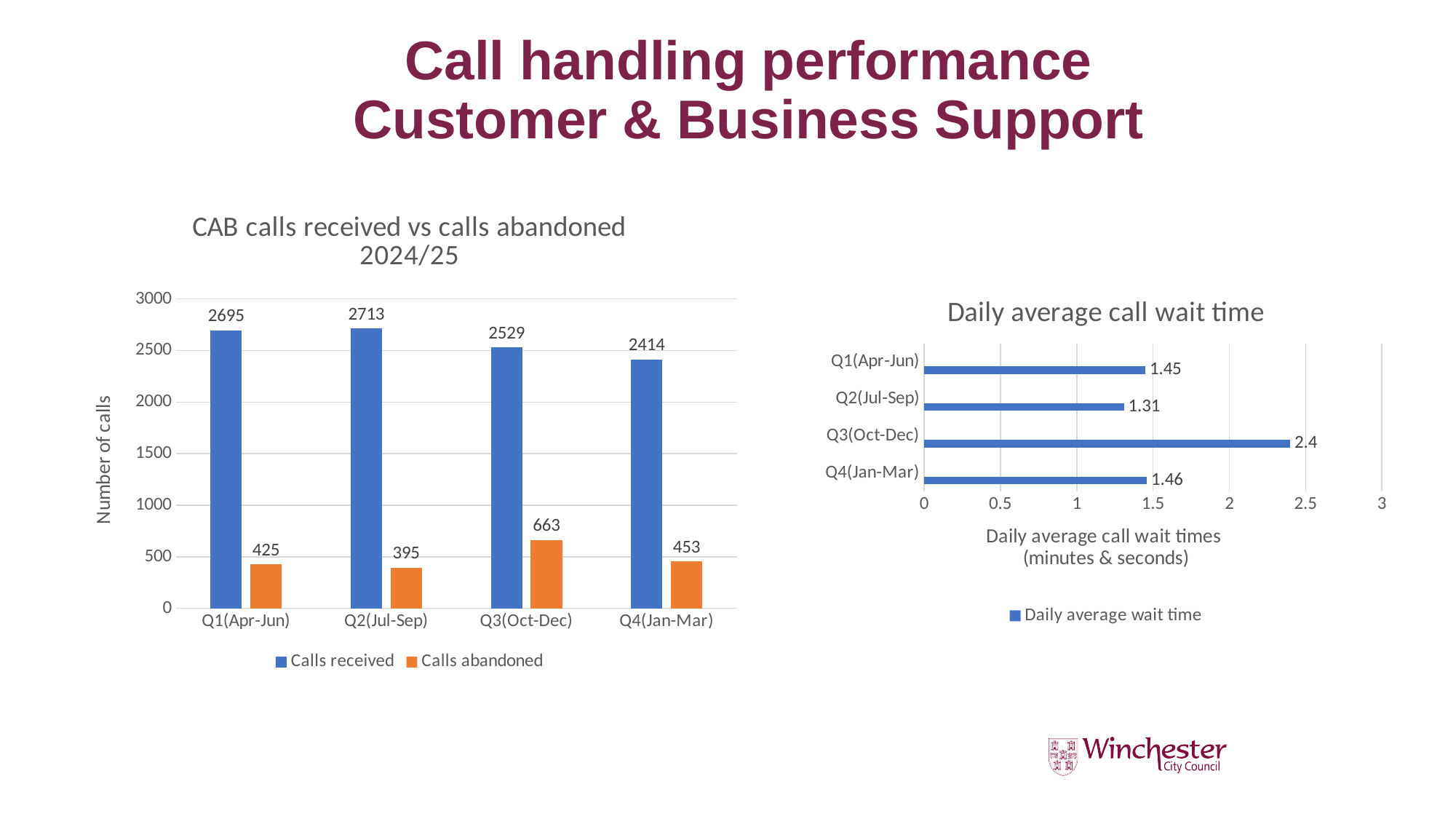
In the 'CAB calls received vs calls abandoned 2024/25' chart, what is the y-axis label? Number of calls In the 'CAB calls received vs calls abandoned 2024/25' chart, how many calls were received in Q2(Jul-Sep)? 2713 In the 'Daily average call wait time' chart, how many quarters are plotted? 4 In the 'CAB calls received vs calls abandoned 2024/25' chart, how many calls were abandoned in Q3(Oct-Dec)? 663 In the 'CAB calls received vs calls abandoned 2024/25' chart, what is the difference between calls received and calls abandoned in Q1(Apr-Jun)? 2270 In the 'CAB calls received vs calls abandoned 2024/25' chart, how many series does the legend list? 2 In the 'CAB calls received vs calls abandoned 2024/25' chart, which quarter had the lowest number of calls received? Q4(Jan-Mar) In the 'Daily average call wait time' chart, which quarter has the lowest daily average wait time? Q2(Jul-Sep) What kind of chart is the 'Daily average call wait time' chart? Bar chart In the 'CAB calls received vs calls abandoned 2024/25' chart, which quarter had the highest number of calls abandoned? Q3(Oct-Dec) In the 'Daily average call wait time' chart, what is the value for Q3(Oct-Dec)? 2.4 In the 'CAB calls received vs calls abandoned 2024/25' chart, were more calls abandoned in Q4(Jan-Mar) or Q2(Jul-Sep)? Q4(Jan-Mar)